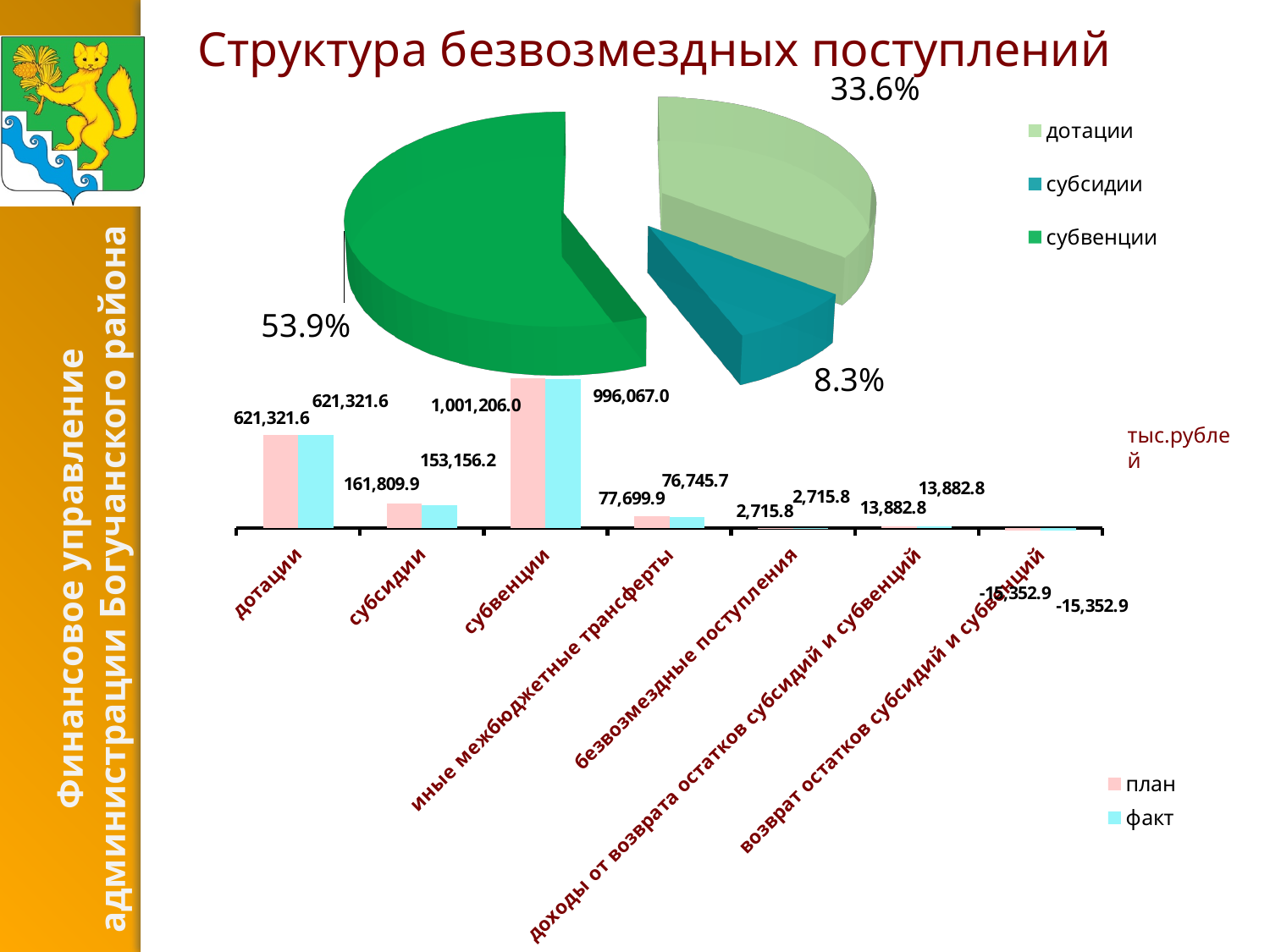
In the bar chart, what is the план value for субвенции? 1,001,206.0 In the bar chart, what is the difference between the план and факт values for субвенции? 5,139.0 In the pie chart, which category has the smallest slice? субсидии In the bar chart, what is the факт value for иные межбюджетные трансферты? 76,745.7 In the bar chart, which category has the highest план value? субвенции How many entries does the legend of the pie chart list? 3 In the pie chart, what share does субвенции have? 53.9% In the bar chart, what is the факт value for субсидии? 153,156.2 How many categories are shown on the x axis of the bar chart? 7 In the pie chart, what share does дотации have? 33.6% What type of chart is the lower chart on the slide? bar chart In the bar chart, which is larger for субсидии: план or факт? план